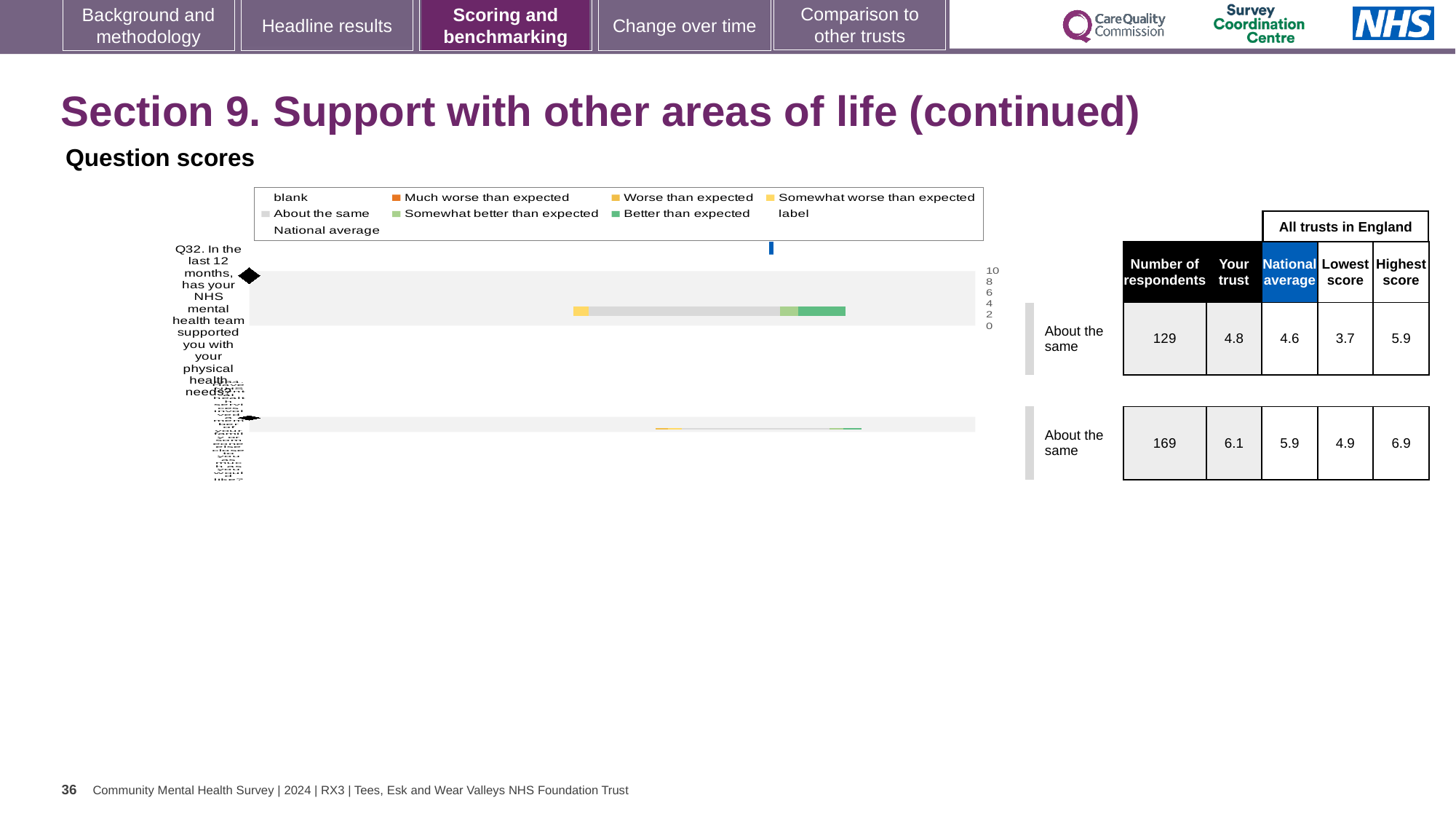
For Q32, is the trust's score higher or lower than the national average? higher What is the difference between the trust's score and the national average for Q32? 0.2 What is the highest score among all trusts in England for Q32? 5.9 How many question rows are plotted in the chart? 2 What is the lowest score among all trusts in England for Q32? 3.7 What is the maximum value shown on the chart's score axis? 10 Which colour in the legend represents 'Better than expected'? green What is the difference between the highest and lowest trust scores in England for Q32? 2.2 What is the 'Your trust' score for Q32 (support with physical health needs)? 4.8 How many respondents answered Q32? 129 What kind of chart is shown under 'Question scores'? bar chart What is the national average score for Q32? 4.6